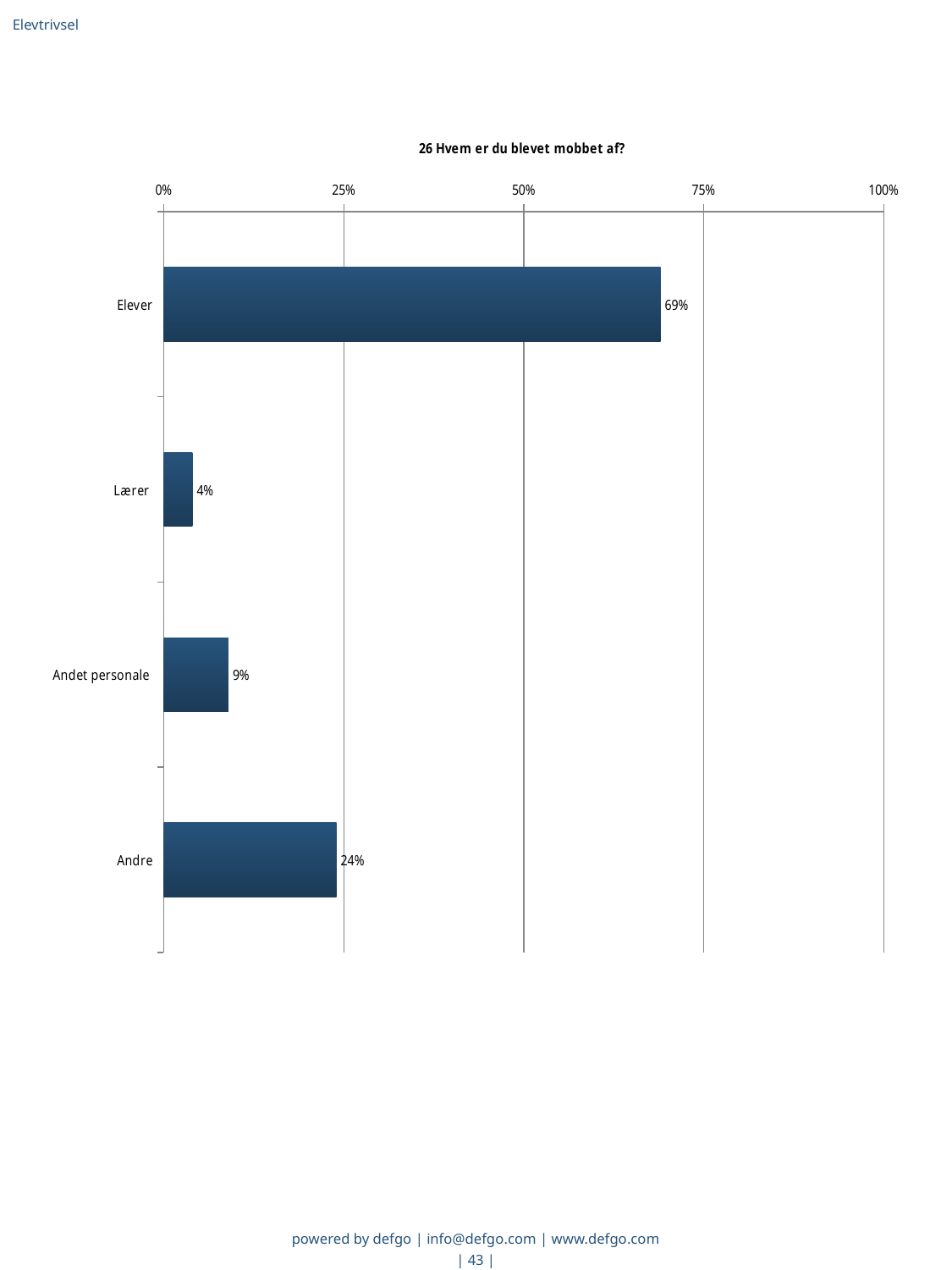
What is the value for Elever? 69% What is the difference between the values for Elever and Andre? 45% What is the difference between the values for Andet personale and Lærer? 5% What kind of chart is shown on the slide? bar chart What is the value for Andre? 24% Which category has the highest value? Elever Which is larger, the value for Andre or the value for Andet personale? Andre Is the value for Elever greater or less than 50%? greater What is the value for Lærer? 4% What is the value for Andet personale? 9% Which category has the lowest value? Lærer How many categories are shown in the chart? 4